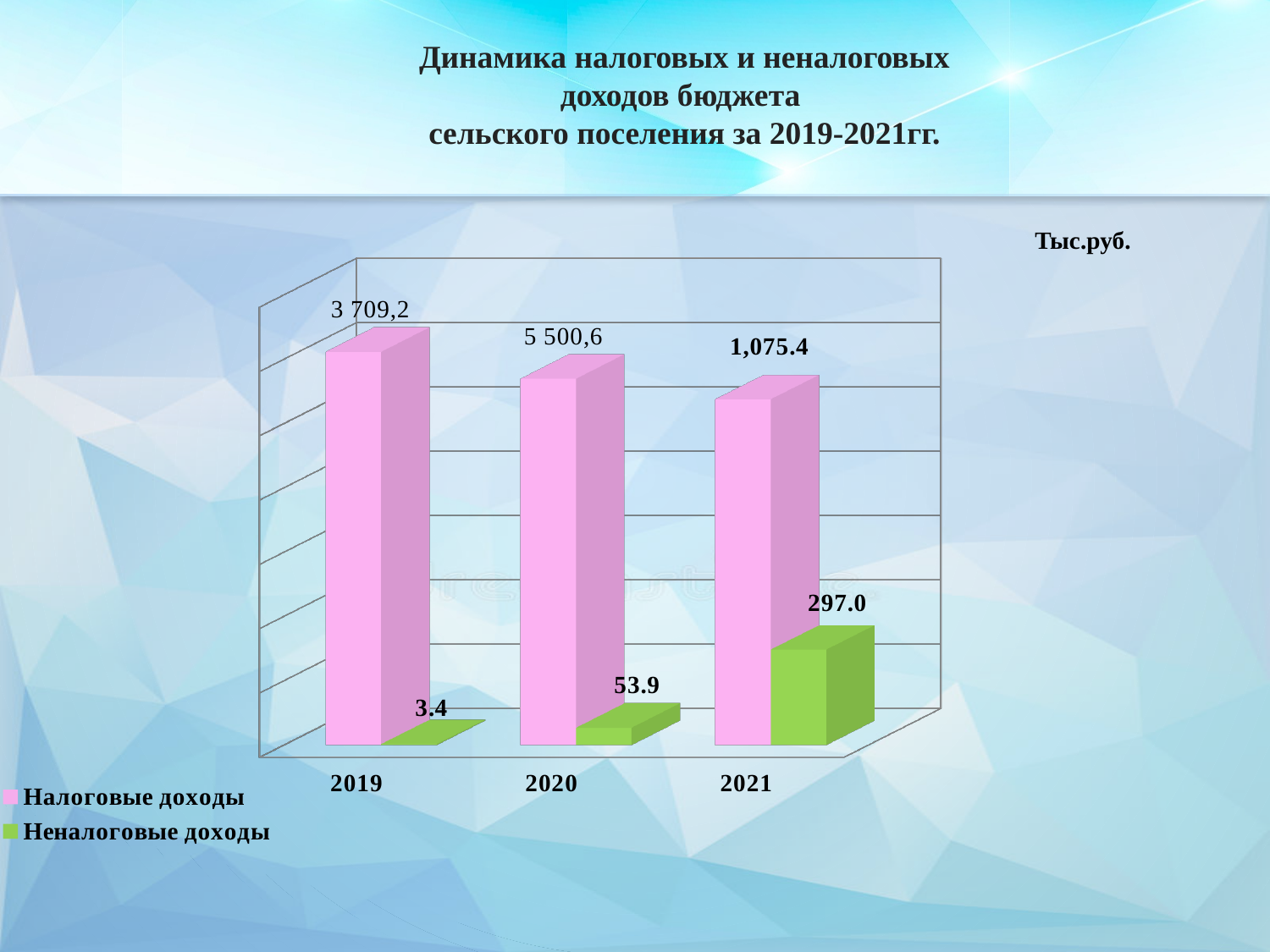
In which year is Неналоговые доходы the lowest? 2019 What is the value of Неналоговые доходы for 2021? 297.0 How many years are shown on the x axis? 3 How many series does the legend list? 2 Do the values of Неналоговые доходы rise or fall from 2019 to 2021? rise What is the value of Налоговые доходы for 2021? 1,075.4 In which year is Неналоговые доходы the highest? 2021 What is the value of Налоговые доходы for 2019? 3 709,2 What is the value of Неналоговые доходы for 2019? 3.4 What is the value of Налоговые доходы for 2020? 5 500,6 Which is larger: Неналоговые доходы in 2020 or in 2019? 2020 What is the difference between Неналоговые доходы in 2021 and 2020? 243.1